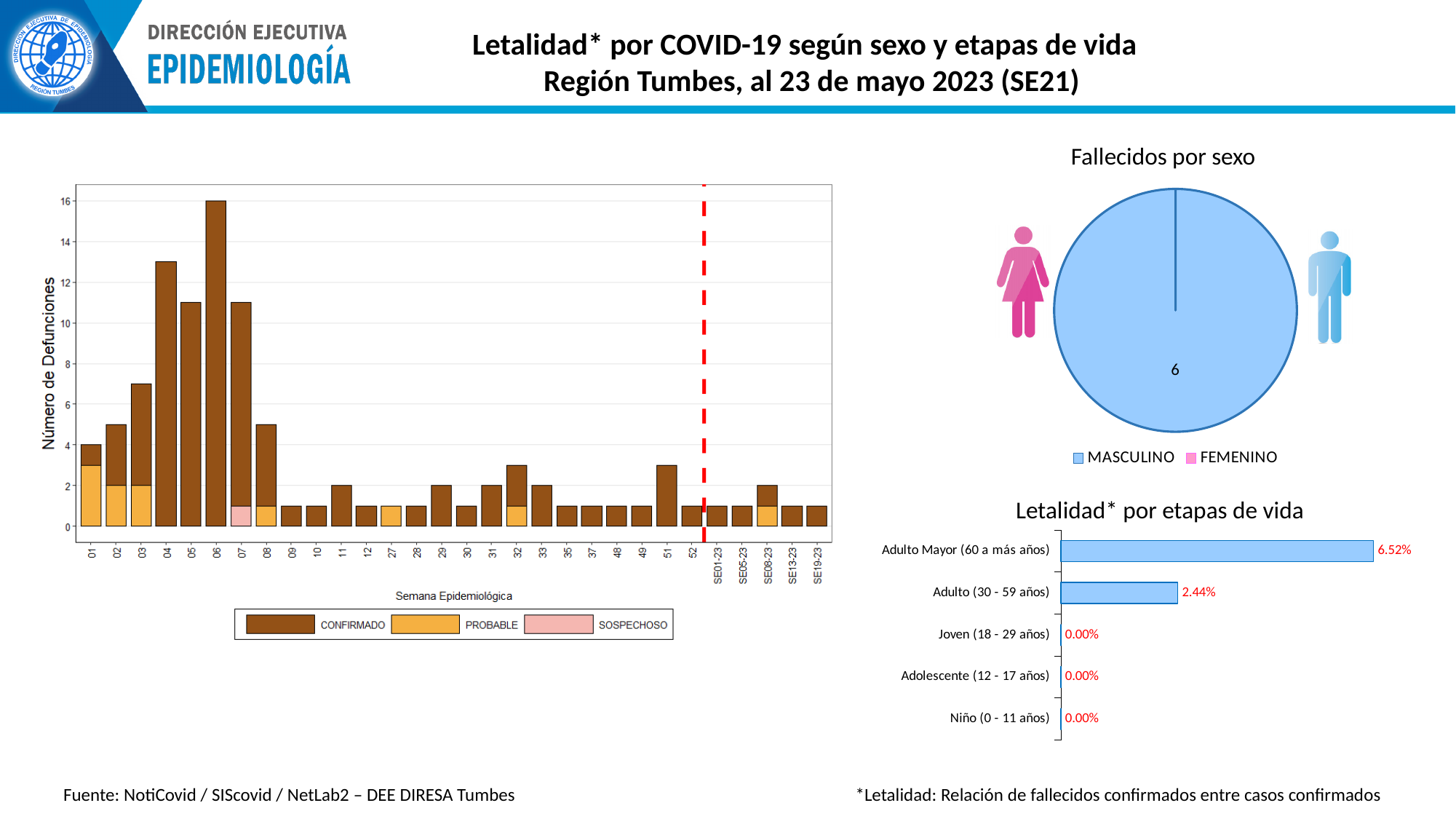
In the 'Letalidad* por etapas de vida' chart, what is the value for Adulto Mayor (60 a más años)? 6.52% What kind of chart is 'Letalidad* por etapas de vida'? bar chart How many entries does the legend of the 'Fallecidos por sexo' chart list? 2 In the 'Número de Defunciones' bar chart on the left, which epidemiological week has the highest number of deaths? 06 In the 'Letalidad* por etapas de vida' chart, which age group has the highest value? Adulto Mayor (60 a más años) How many age groups are shown in the 'Letalidad* por etapas de vida' chart? 5 In the 'Letalidad* por etapas de vida' chart, what is the difference between the values for Adulto Mayor (60 a más años) and Adulto (30 - 59 años)? 4.08% In the 'Número de Defunciones' bar chart on the left, how many deaths are shown for week 06? 16 What kind of chart is 'Fallecidos por sexo'? pie chart In the 'Fallecidos por sexo' chart, what is the value shown for MASCULINO? 6 How many series does the legend of the 'Número de Defunciones' bar chart on the left list? 3 In the 'Letalidad* por etapas de vida' chart, what is the value for Adulto (30 - 59 años)? 2.44%